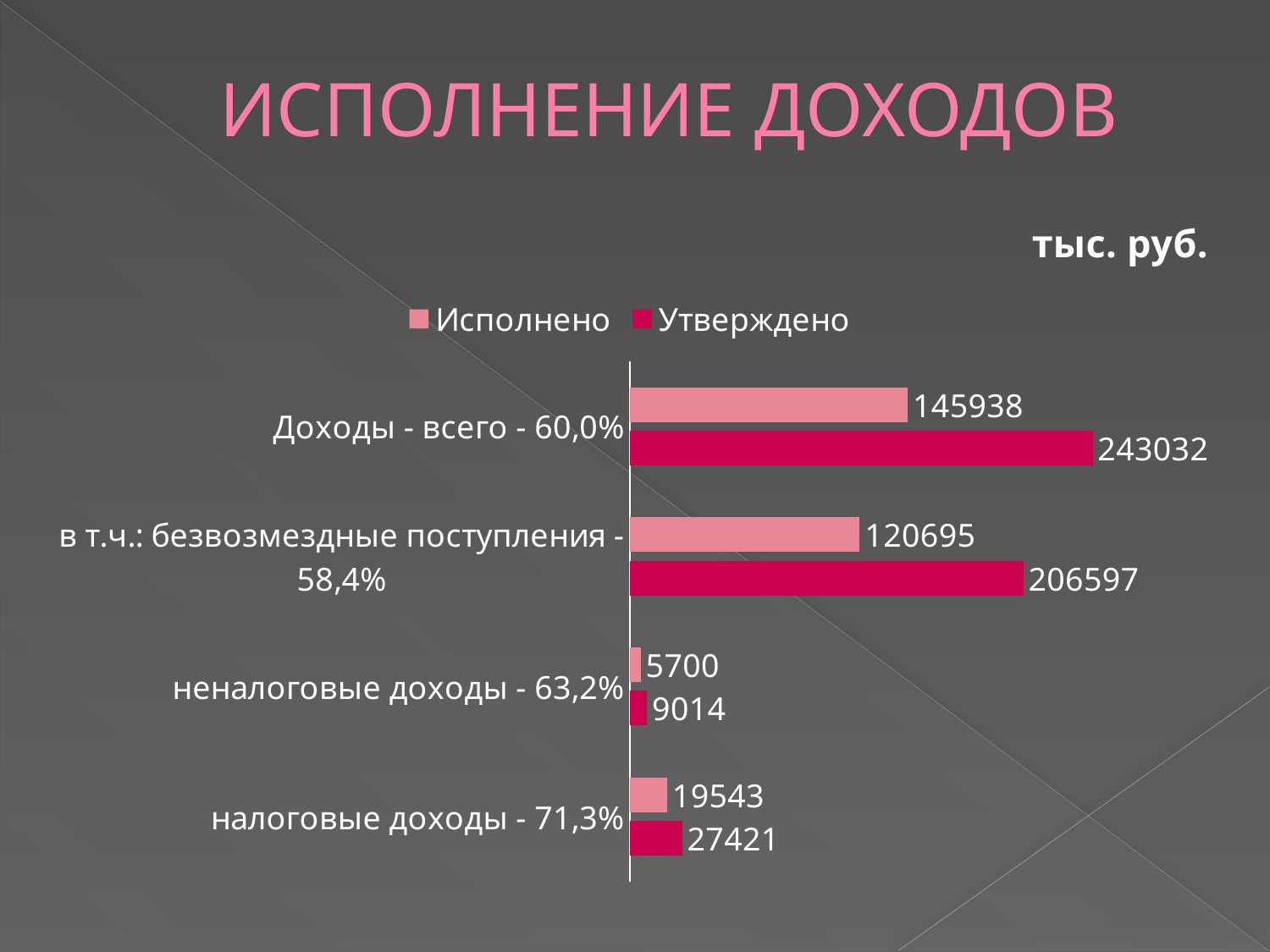
How many categories are shown on the chart? 4 What is the Утверждено value for "Доходы - всего - 60,0%"? 243032 What is the Исполнено value for "в т.ч.: безвозмездные поступления - 58,4%"? 120695 How many series does the legend list? 2 What is the Исполнено value for "Доходы - всего - 60,0%"? 145938 Which is larger for "в т.ч.: безвозмездные поступления - 58,4%": the Исполнено value or the Утверждено value? Утверждено What is the difference between the Утверждено and Исполнено values for "налоговые доходы - 71,3%"? 7878 What unit is indicated above the chart? тыс. руб. What type of chart is shown on the slide? bar chart What is the Исполнено value for "налоговые доходы - 71,3%"? 19543 Which category has the lowest Исполнено value? неналоговые доходы - 63,2% What is the Утверждено value for "неналоговые доходы - 63,2%"? 9014